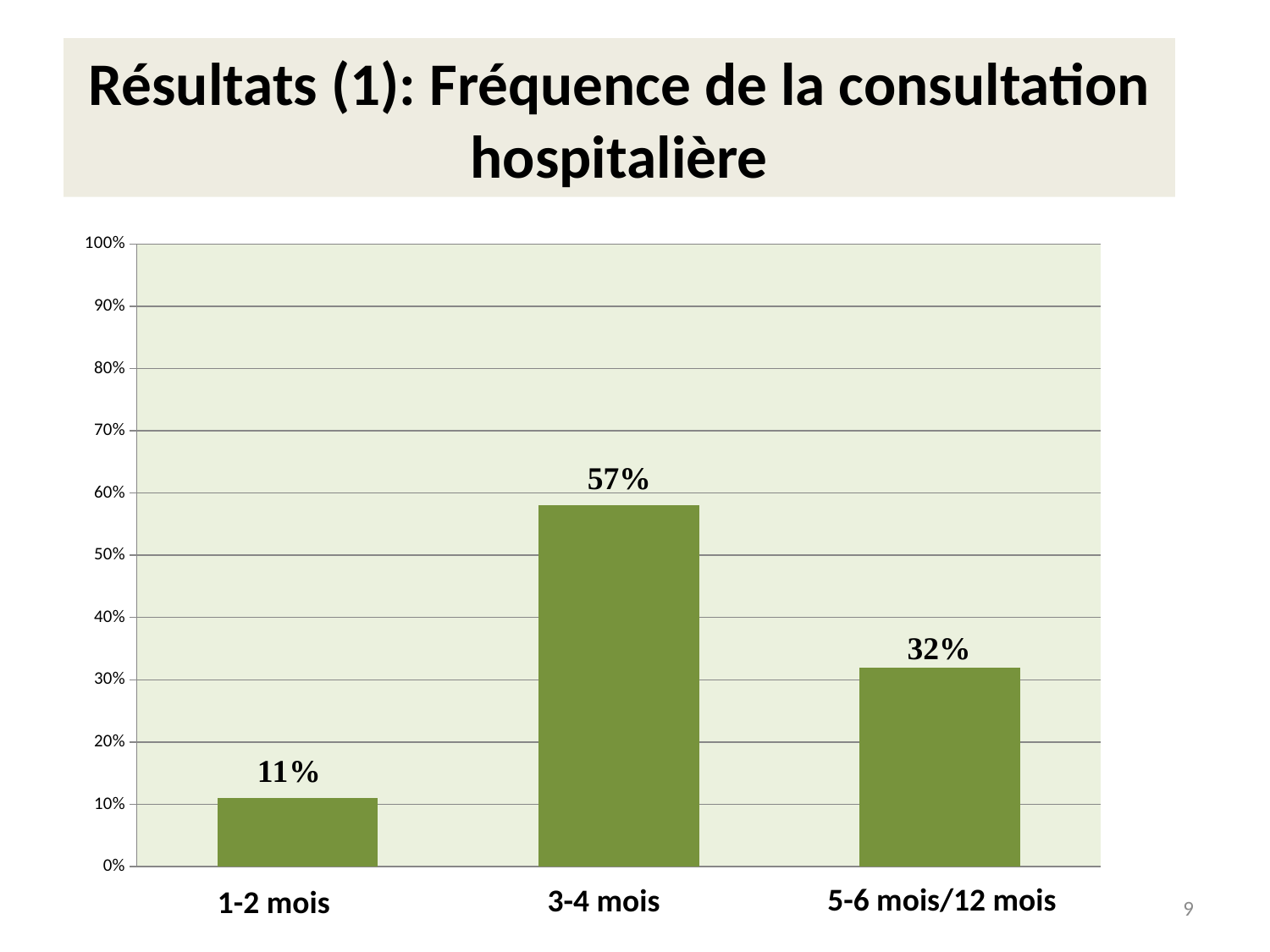
What kind of chart is shown on the slide? bar chart What is the title of the slide containing the chart? Résultats (1): Fréquence de la consultation hospitalière Is the value for 3-4 mois greater or less than 50%? greater Which category has the highest value? 3-4 mois How many categories are shown on the x axis? 3 What is the value for 1-2 mois? 11% What is the difference between the values for 5-6 mois/12 mois and 1-2 mois? 21% What is the value for 5-6 mois/12 mois? 32% Which category has the lowest value? 1-2 mois What is the difference between the values for 3-4 mois and 5-6 mois/12 mois? 25% Which is larger, the value for 1-2 mois or the value for 5-6 mois/12 mois? 5-6 mois/12 mois What is the value for 3-4 mois? 57%